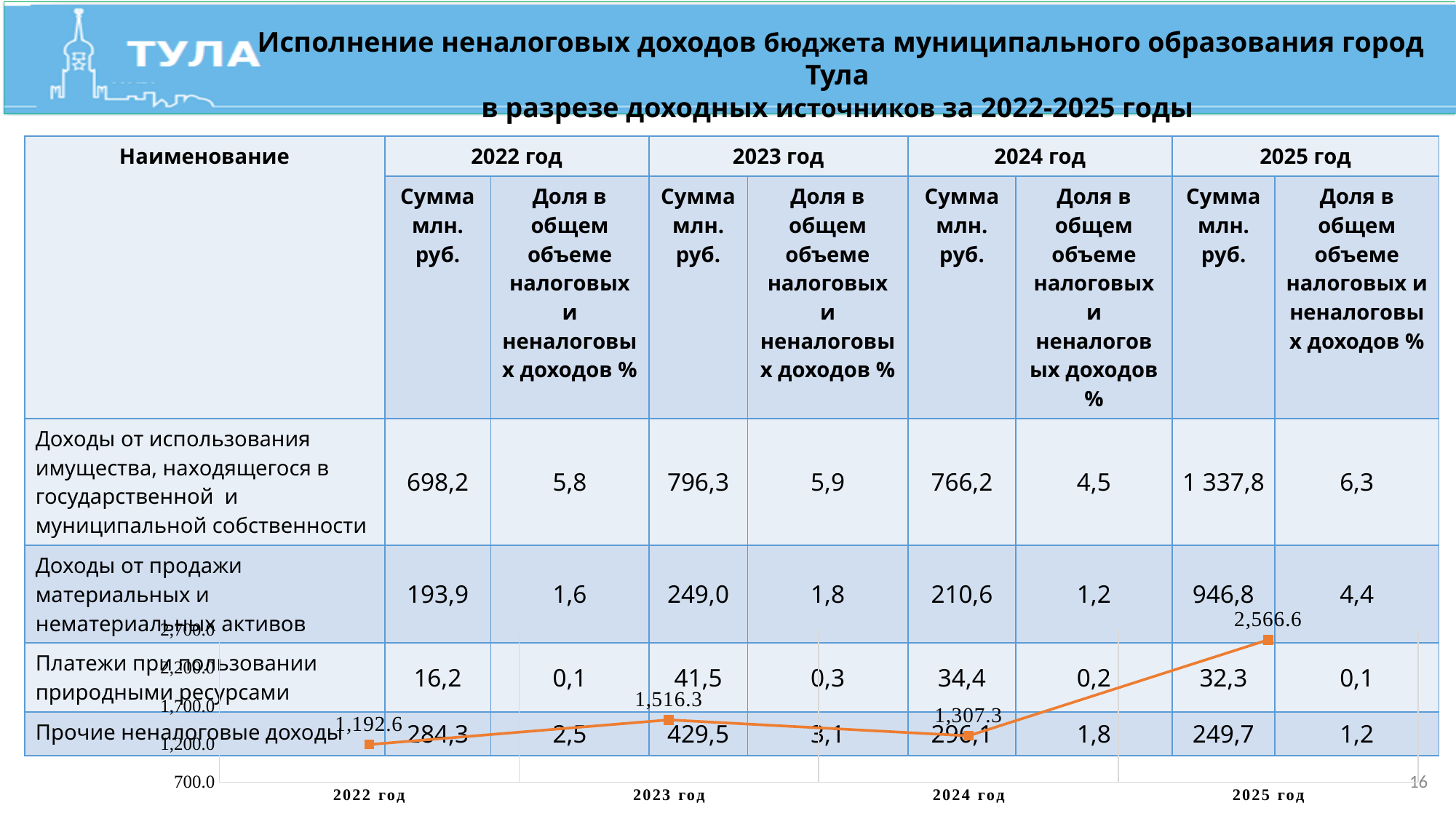
In the line chart, what is the value for 2024 год? 1,307.3 In the line chart, how many data points are plotted? 4 In the line chart, what is the value for 2023 год? 1,516.3 In the line chart, which year has the lowest value? 2022 год In the line chart, what is the difference between the values for 2025 год and 2024 год? 1,259.3 In the line chart, what is the value for 2022 год? 1,192.6 In the line chart, which is larger: the value for 2023 год or the value for 2024 год? 2023 год In the line chart, does the value rise or fall from 2023 год to 2024 год? fall In the line chart, which year has the highest value? 2025 год In the line chart, is the value for 2025 год greater or less than 2,200.0? greater In the line chart, what is the value for 2025 год? 2,566.6 What type of chart is shown at the bottom of the slide? line chart